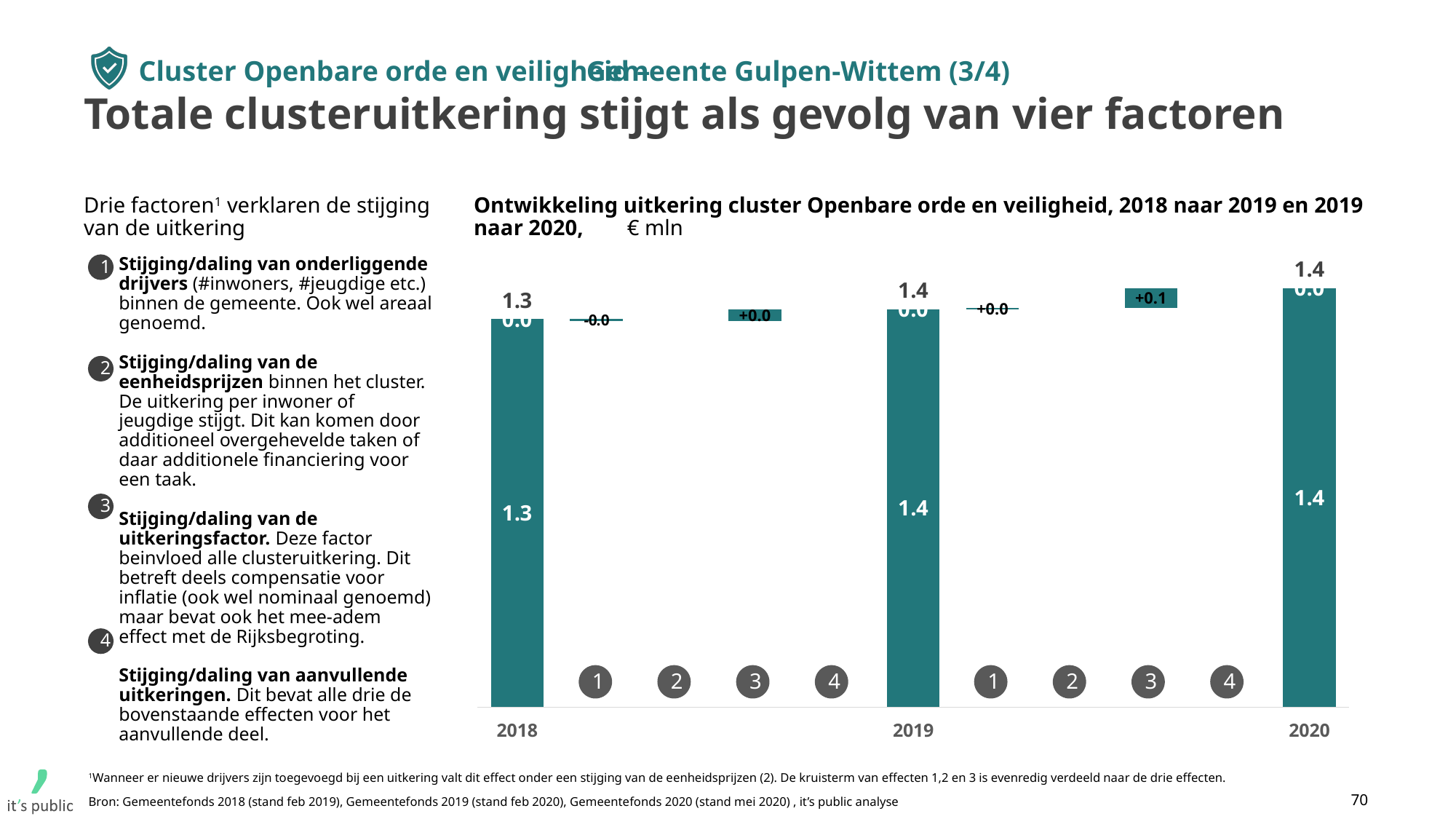
What is the value of factor 1 in the step from 2018 to 2019? -0.0 What is the total value shown above the 2019 bar? 1.4 Which is larger, the total for 2018 or the total for 2019? 2019 In what unit are the values in the chart expressed? € mln Do the year totals rise or fall from 2018 to 2020? rise Which year has the lowest total uitkering? 2018 What is the total value shown above the 2018 bar? 1.3 What is the value of factor 3 in the step from 2019 to 2020? +0.1 What is the difference between the 2019 total and the 2018 total? 0.1 What is the value of factor 1 in the step from 2019 to 2020? +0.0 How many year totals are shown on the x axis? 3 What is the total value shown above the 2020 bar? 1.4